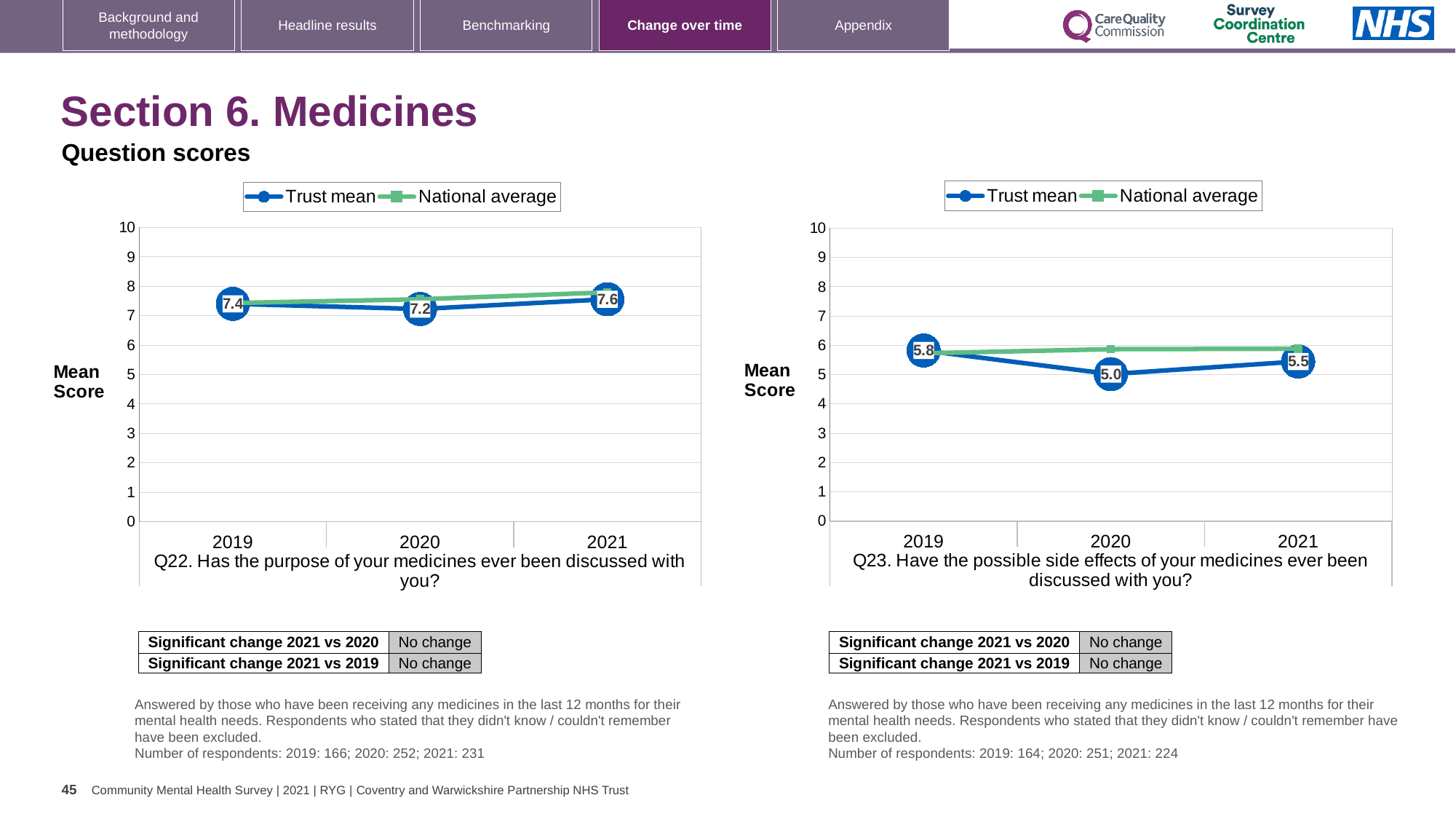
On the Q23 chart (right), what is the difference between the Trust mean scores for 2019 and 2020? 0.8 On the Q23 chart (right), what is the Trust mean score for 2020? 5.0 On the Q22 chart (left), how many years are shown on the x axis? 3 On the Q22 chart (left), what is the Trust mean score for 2019? 7.4 On the Q22 chart (left), what is the Trust mean score for 2021? 7.6 On the Q22 chart (left), which year has the highest Trust mean score? 2021 On the Q23 chart (right), is the Trust mean score for 2019 greater or less than 6? less On the Q23 chart (right), what is the Trust mean score for 2021? 5.5 On the Q22 chart (left), how many series does the legend list? 2 On the Q22 chart (left), what is the difference between the Trust mean scores for 2021 and 2020? 0.4 What kind of chart is the Q23 chart (right)? Line chart On the Q23 chart (right), which year has the lowest Trust mean score? 2020